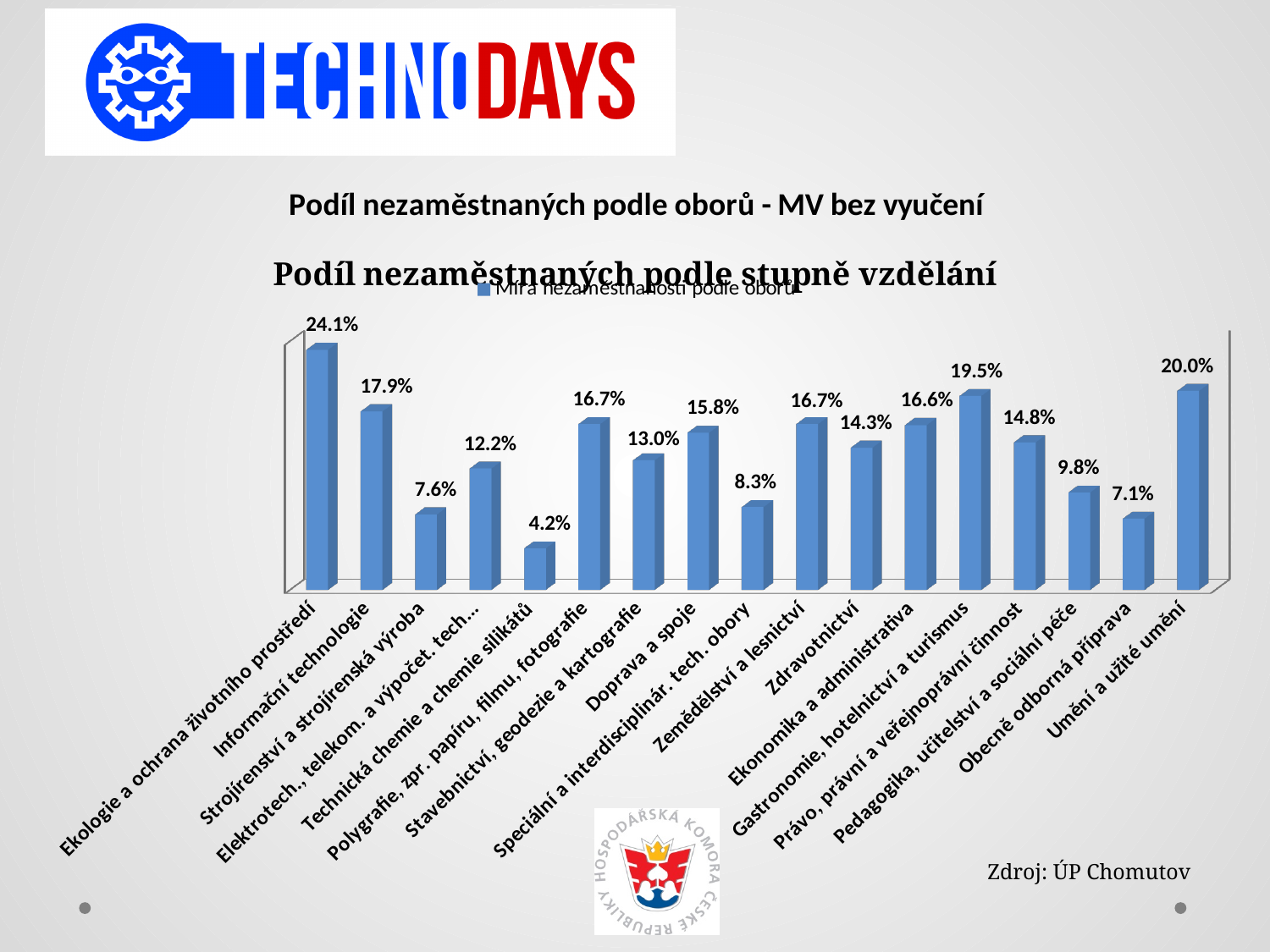
What kind of chart is shown on the slide? Bar chart What is the value for Umění a užité umění? 20.0% What is the value for Gastronomie, hotelnictví a turismus? 19.5% How many categories are shown in the chart? 17 What is the source cited at the bottom of the slide? ÚP Chomutov What is the value for Technická chemie a chemie silikátů? 4.2% Which category has the highest value? Ekologie a ochrana životního prostředí What is the difference between the values for Umění a užité umění and Obecně odborná příprava? 12.9% Which category has the lowest value? Technická chemie a chemie silikátů Which is larger, the value for Doprava a spoje or the value for Zdravotnictví? Doprava a spoje What is the value for Ekologie a ochrana životního prostředí? 24.1% What is the difference between the values for Informační technologie and Strojírenství a strojírenská výroba? 10.3%